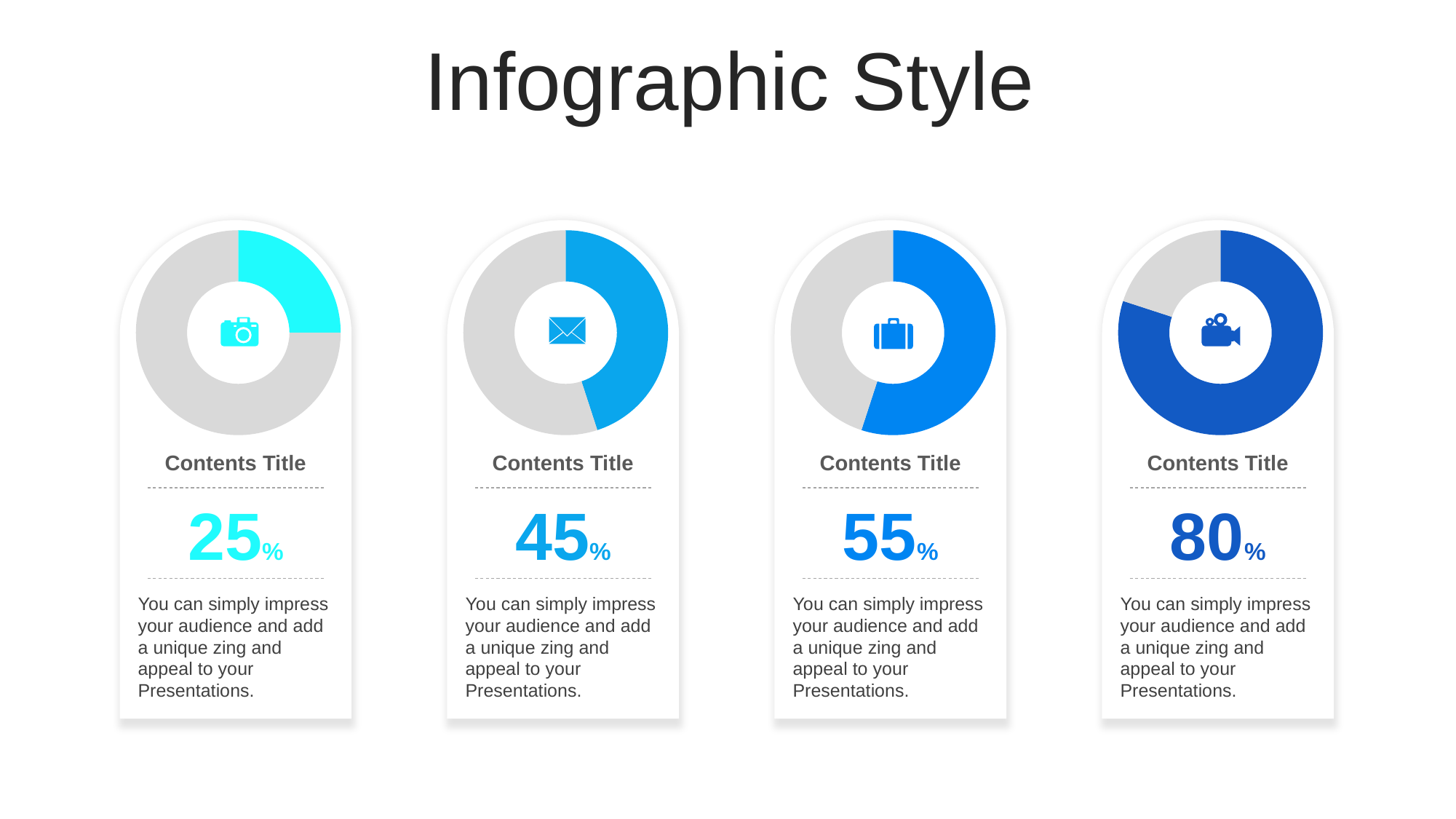
Do the percentages increase or decrease from the leftmost chart to the rightmost chart? Increase Which of the four donut charts shows the lowest percentage? The leftmost chart (camera icon), 25% What percentage is shown for the leftmost donut chart (with the camera icon)? 25% What is the difference between the percentage in the rightmost donut chart and the percentage in the leftmost donut chart? 55% Which is larger: the percentage in the second donut chart from the left or the percentage in the third donut chart from the left? The third chart (55%) What percentage is shown for the rightmost donut chart (with the video camera icon)? 80% Which of the four donut charts shows the highest percentage? The rightmost chart (video camera icon), 80% What percentage is shown for the third donut chart from the left (with the briefcase icon)? 55% What percentage is shown for the second donut chart from the left (with the envelope icon)? 45% What is the difference between the percentages shown in the third and second donut charts from the left? 10% What kind of chart is used for each of the four items on the slide? Donut chart How many donut charts are on the slide? 4